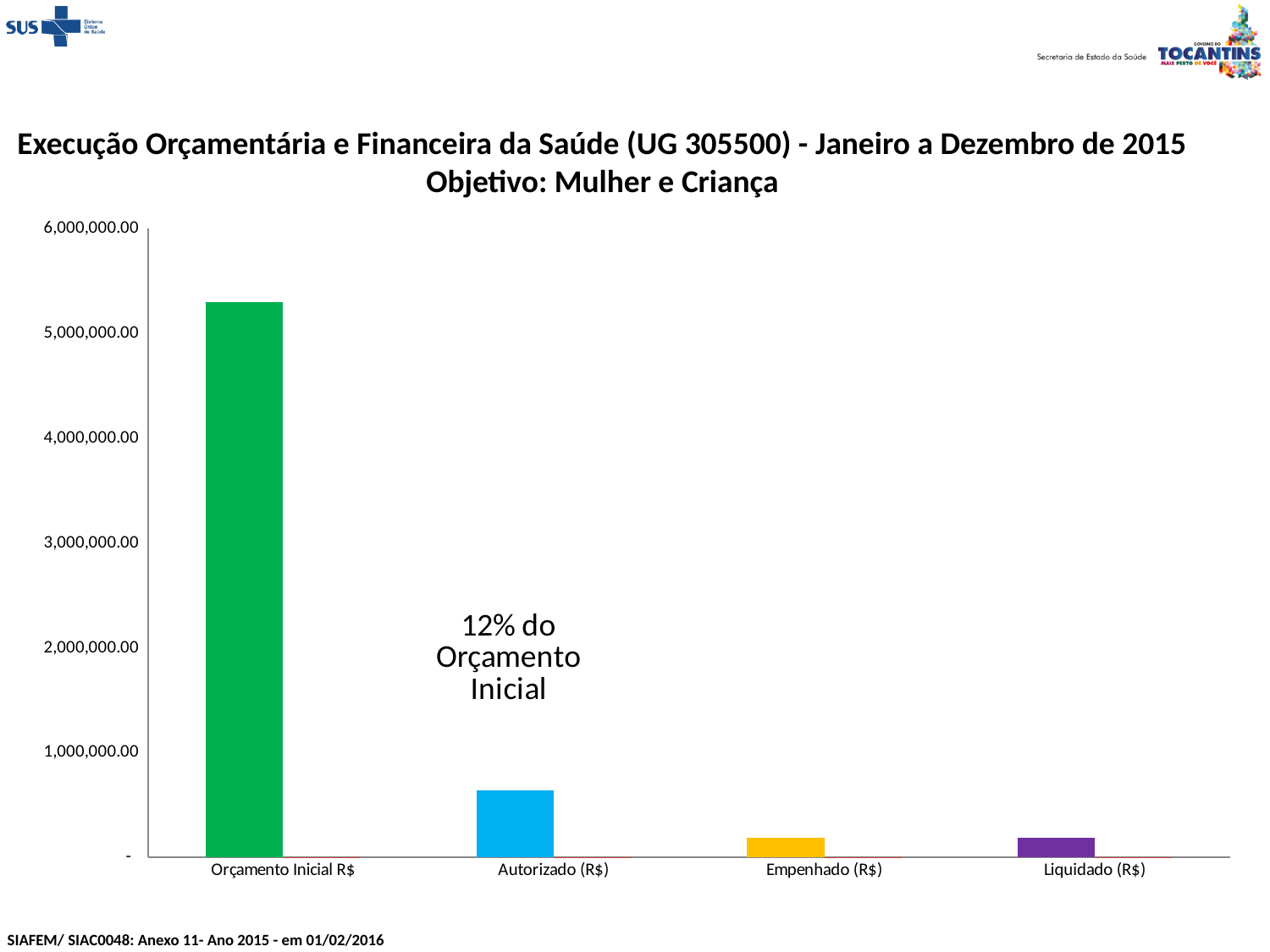
How many categories are plotted on the x axis of the chart? 4 Is the value for Orçamento Inicial R$ greater or less than 5,000,000.00? greater Is the value for Autorizado (R$) greater or less than 1,000,000.00? less What colour is the bar for Orçamento Inicial R$? green Is the value for Orçamento Inicial R$ greater or less than 6,000,000.00? less What kind of chart is shown on the slide? bar chart Which is larger, the value for Orçamento Inicial R$ or the value for Autorizado (R$)? Orçamento Inicial R$ Which category has the highest value in the chart? Orçamento Inicial R$ According to the annotation on the chart, what percentage of the Orçamento Inicial does the Autorizado value represent? 12% Which is larger, the value for Autorizado (R$) or the value for Empenhado (R$)? Autorizado (R$)